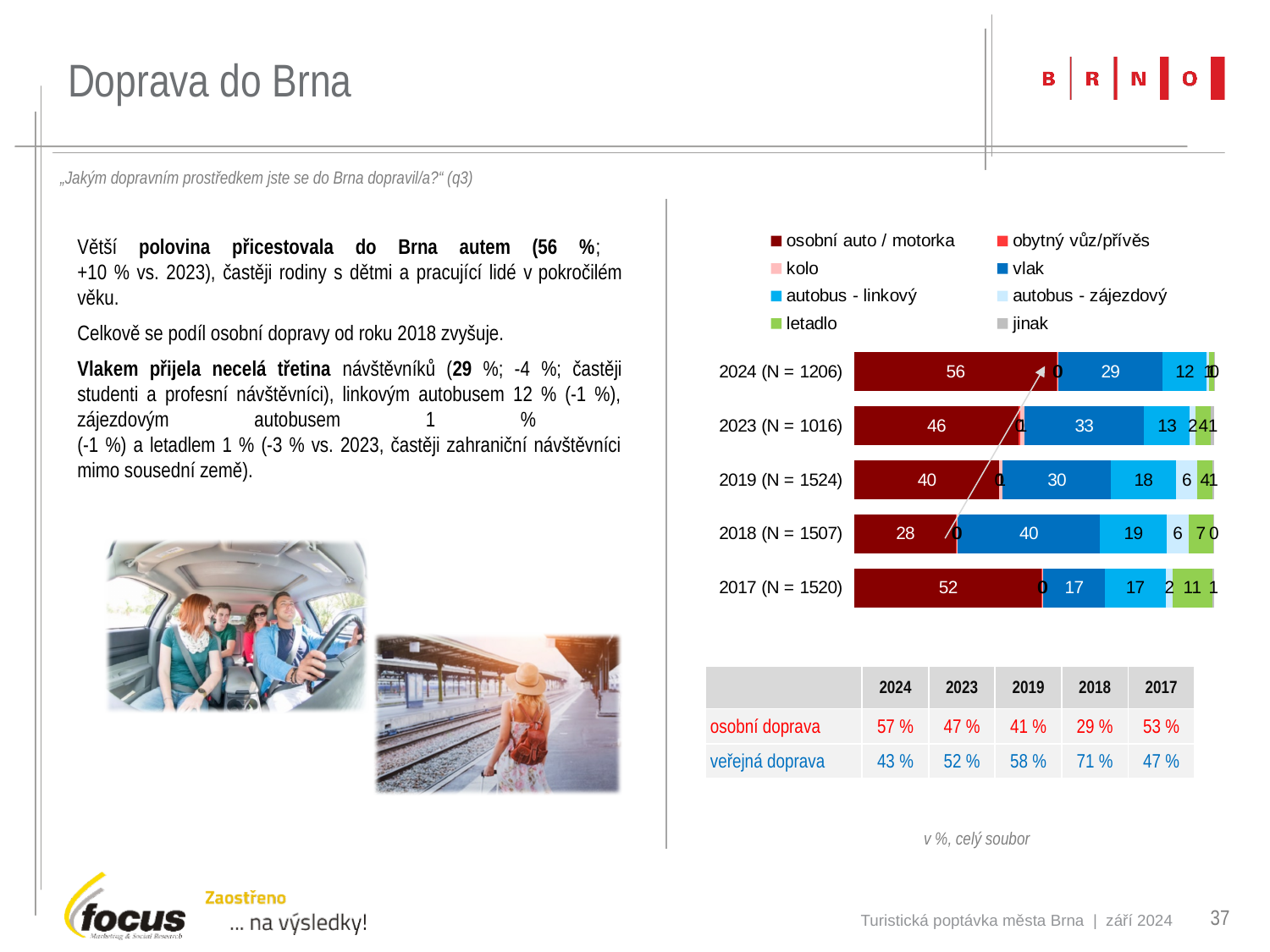
How many series does the chart legend list? 8 What is the difference between the 'osobní auto / motorka' values for 2024 and 2023? 10 Which is larger in 2017 (N = 1520): the value for 'osobní auto / motorka' or the value for 'vlak'? osobní auto / motorka What kind of chart is shown on the slide? stacked bar chart Which series is shown in dark red in the chart? osobní auto / motorka How many year categories are plotted in the chart? 5 What is the value for 'osobní auto / motorka' in 2024 (N = 1206)? 56 What is the value for 'vlak' in 2023 (N = 1016)? 33 What is the value for 'autobus - linkový' in 2019 (N = 1524)? 18 In which year is the value for 'osobní auto / motorka' the lowest? 2018 (N = 1507) What is the value for 'vlak' in 2018 (N = 1507)? 40 In which year is the value for 'vlak' the highest? 2018 (N = 1507)